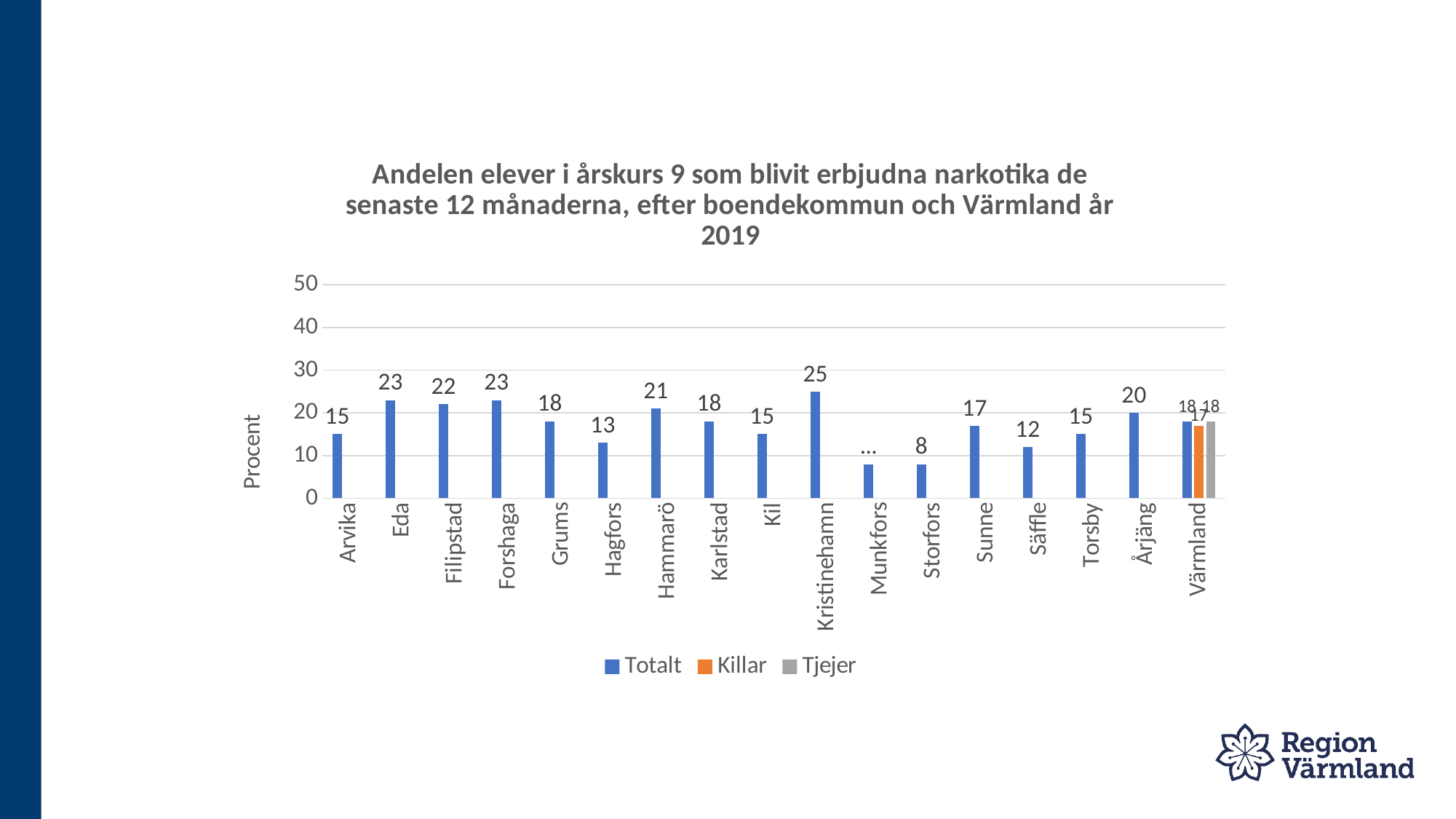
Which has a larger Totalt value, Hammarö or Grums? Hammarö Which municipality has the highest Totalt value? Kristinehamn Is the Totalt value for Storfors greater or less than 10? less What is the Tjejer value for Värmland? 18 How many categories are shown on the x axis? 17 What kind of chart is shown on the slide? bar chart What is the Totalt value for Kristinehamn? 25 What is the label of the y axis? Procent What is the Killar value for Värmland? 17 What is the difference between the Totalt values for Eda and Säffle? 11 How many series does the legend list? 3 What is the Totalt value for Hagfors? 13